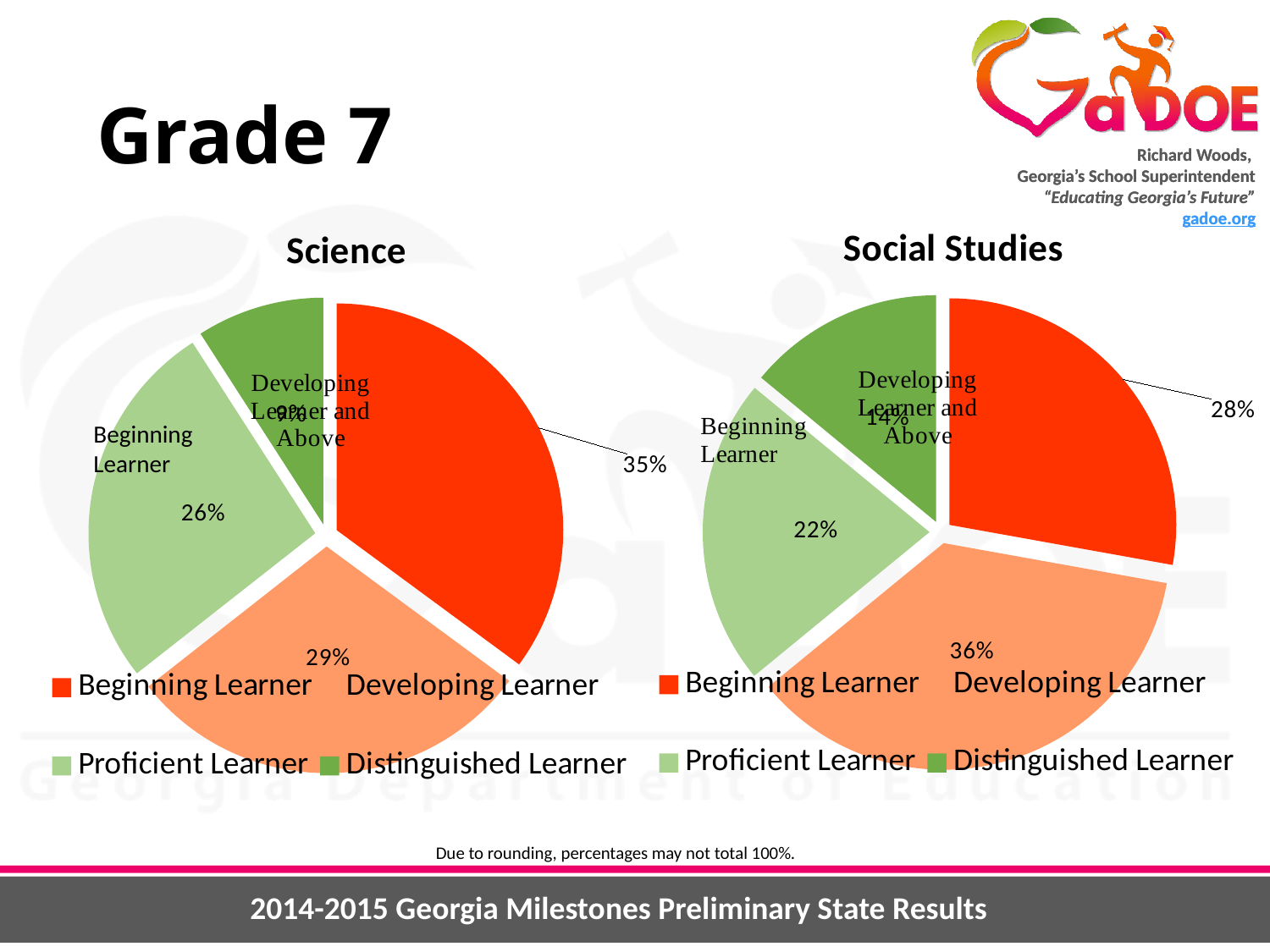
In the Social Studies pie chart, what percentage is shown for Developing Learner? 36% In the Science pie chart, what percentage is shown for Developing Learner? 29% In the Science pie chart, what percentage is shown for Beginning Learner? 35% In the Social Studies pie chart, what is the difference between the Developing Learner and Beginning Learner percentages? 8% What colour represents Beginning Learner in the pie charts? Red In the Social Studies pie chart, what percentage is shown for Distinguished Learner? 14% How many categories does the legend of the Social Studies pie chart list? 4 In the Social Studies pie chart, which category has the largest share? Developing Learner In the Social Studies pie chart, which category has the smallest share? Distinguished Learner In the Science pie chart, which is larger: Developing Learner or Proficient Learner? Developing Learner In the Science pie chart, which category has the largest share? Beginning Learner What type of chart is used for the Science results? Pie chart